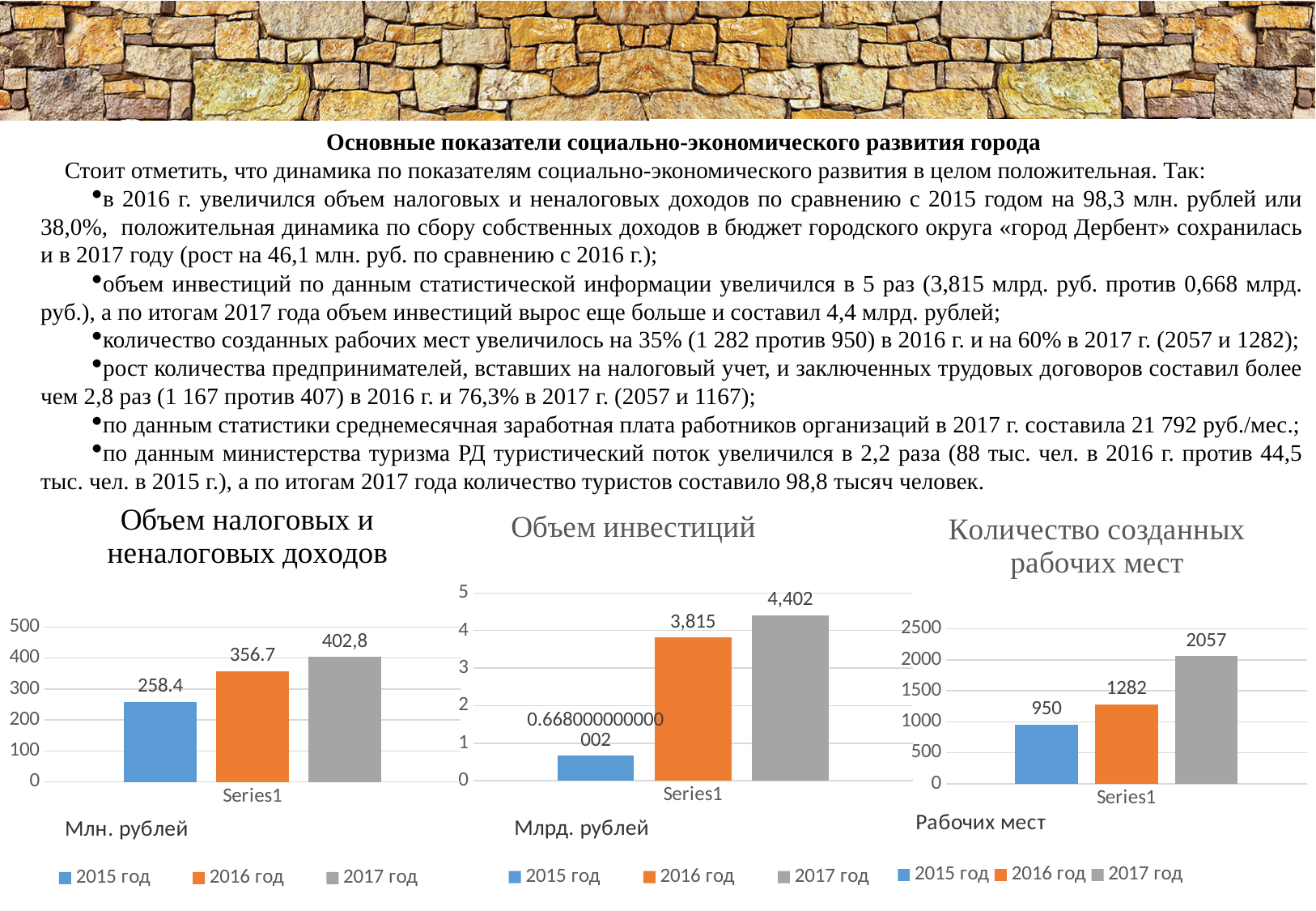
In the chart titled "Количество созданных рабочих мест", which year has the highest value? 2017 год In the chart titled "Количество созданных рабочих мест", what is the value for 2016 год? 1282 In the chart titled "Количество созданных рабочих мест", what is the difference between the 2017 год and 2016 год values? 775 In the chart titled "Количество созданных рабочих мест", do the values rise or fall from 2015 год to 2017 год? rise In the chart titled "Объем инвестиций", is the value for 2017 год greater or less than 4? greater In the chart titled "Объем инвестиций", which year has the lowest value? 2015 год What type of chart is the chart titled "Объем налоговых и неналоговых доходов"? bar chart In the chart titled "Объем налоговых и неналоговых доходов", what is the difference between the 2016 год and 2015 год values? 98.3 How many series does the legend of the chart titled "Объем инвестиций" list? 3 In the chart titled "Объем инвестиций", what is the value for 2016 год? 3,815 In the chart titled "Объем налоговых и неналоговых доходов", what is the value for 2015 год? 258.4 In the chart titled "Объем налоговых и неналоговых доходов", what is the value for 2017 год? 402,8